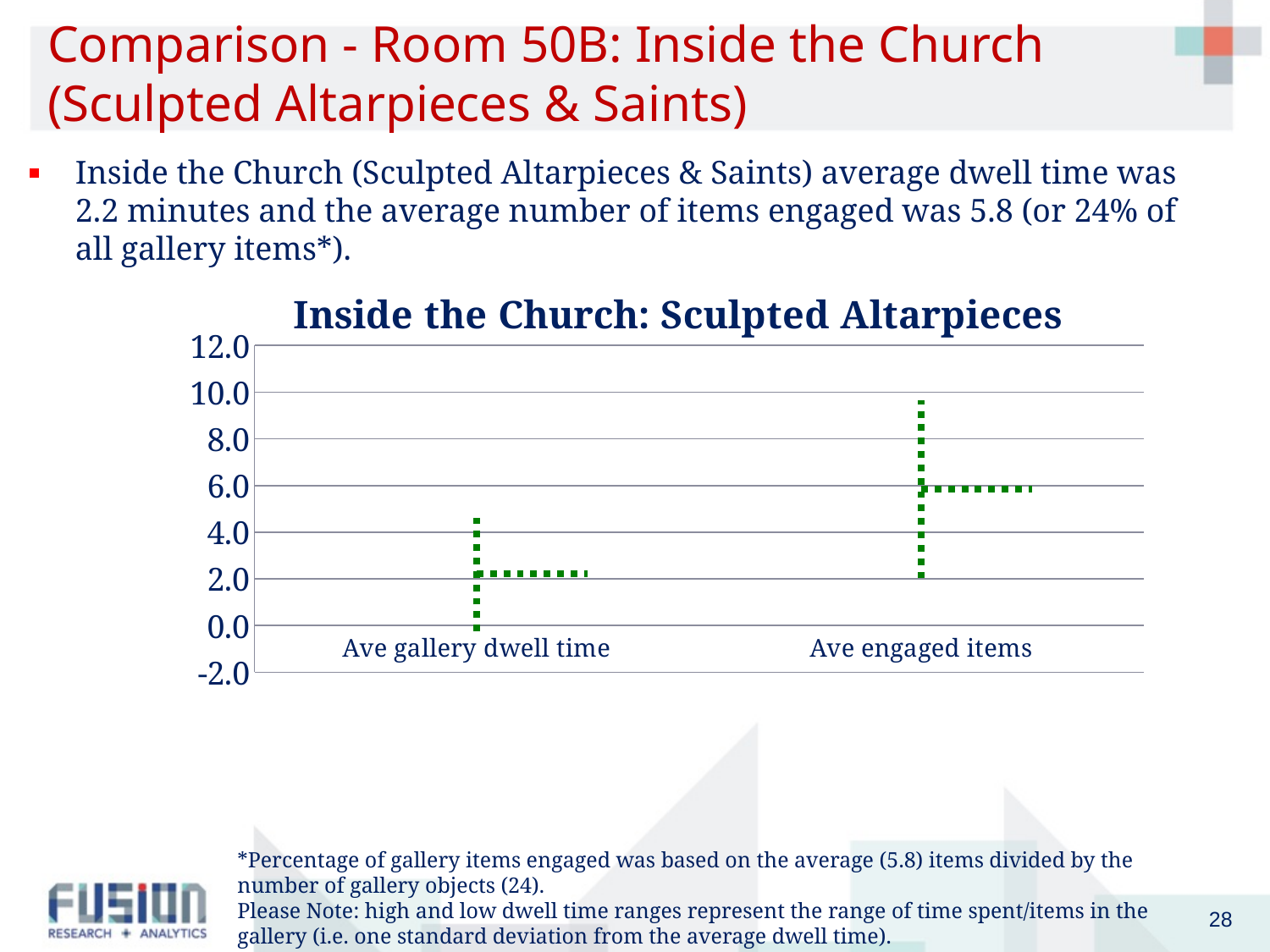
Is the value for Ave engaged items greater or less than 4.0? greater What is the highest value shown on the chart's y axis? 12.0 Which category has the lowest value in the chart? Ave gallery dwell time How many categories are shown on the x axis of the chart? 2 What is the value for Ave gallery dwell time in the chart? 2.2 Which category has the highest value in the chart? Ave engaged items What is the title of the chart? Inside the Church: Sculpted Altarpieces What is the difference between the value for Ave engaged items and the value for Ave gallery dwell time? 3.6 What is the value for Ave engaged items in the chart? 5.8 Which category has the higher value, Ave gallery dwell time or Ave engaged items? Ave engaged items Is the value for Ave gallery dwell time greater or less than 4.0? less